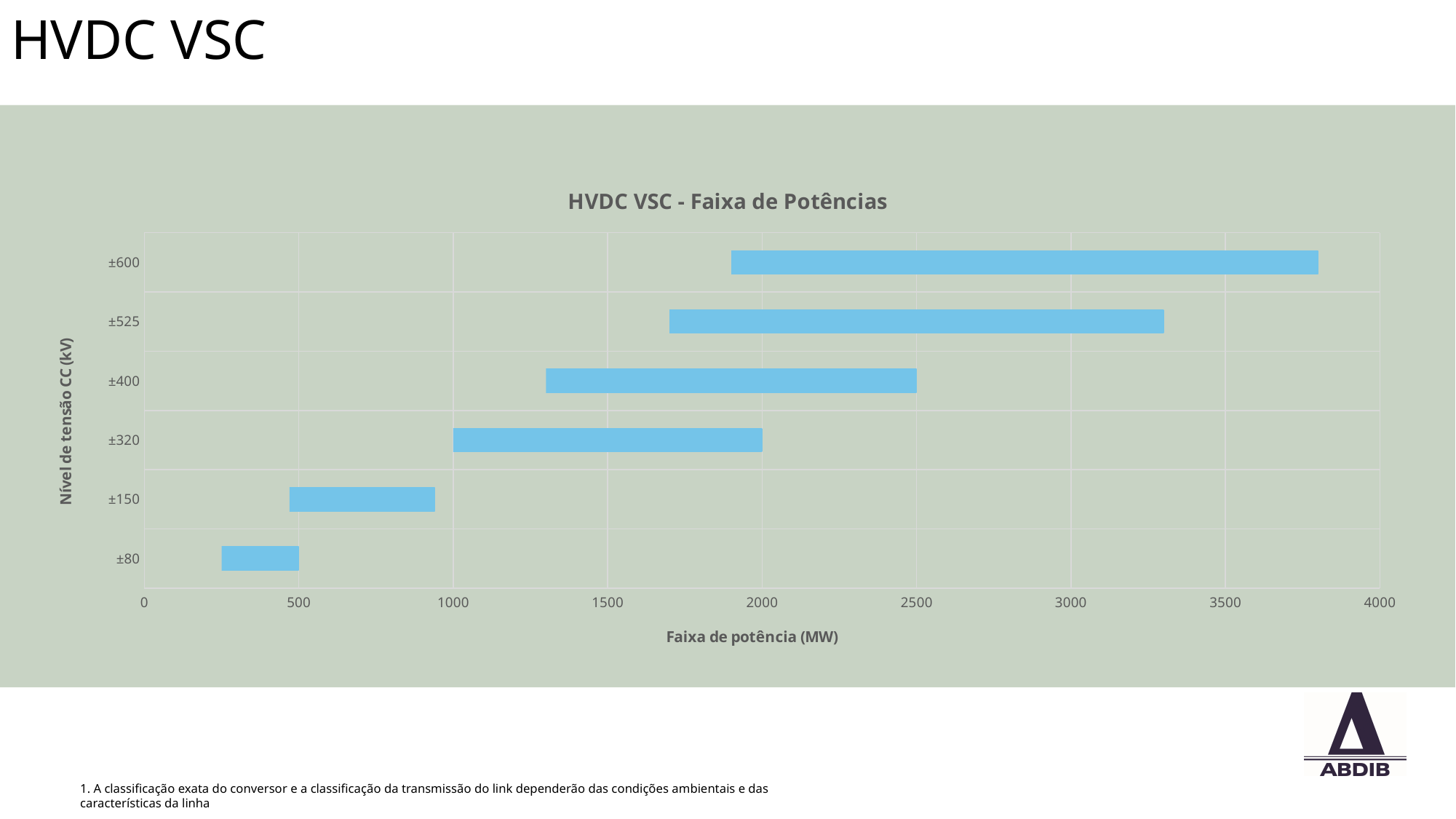
Which bar reaches a higher power value, ±525 or ±400? ±525 What is the title of the chart? HVDC VSC - Faixa de Potências Is the upper end of the bar for ±150 greater or less than 1000? less Is the upper end of the bar for ±600 greater or less than 3500? greater How many voltage levels (categories) are plotted on the y axis? 6 Which voltage level has the bar with the lowest power values? ±80 At what power value (MW) does the bar for ±80 end? 500 At what power value (MW) does the bar for ±320 end? 2000 What is the label of the x axis? Faixa de potência (MW) What kind of chart is shown on the slide? bar chart Which voltage level has the bar reaching the highest power value? ±600 At what power value (MW) does the bar for ±320 start? 1000